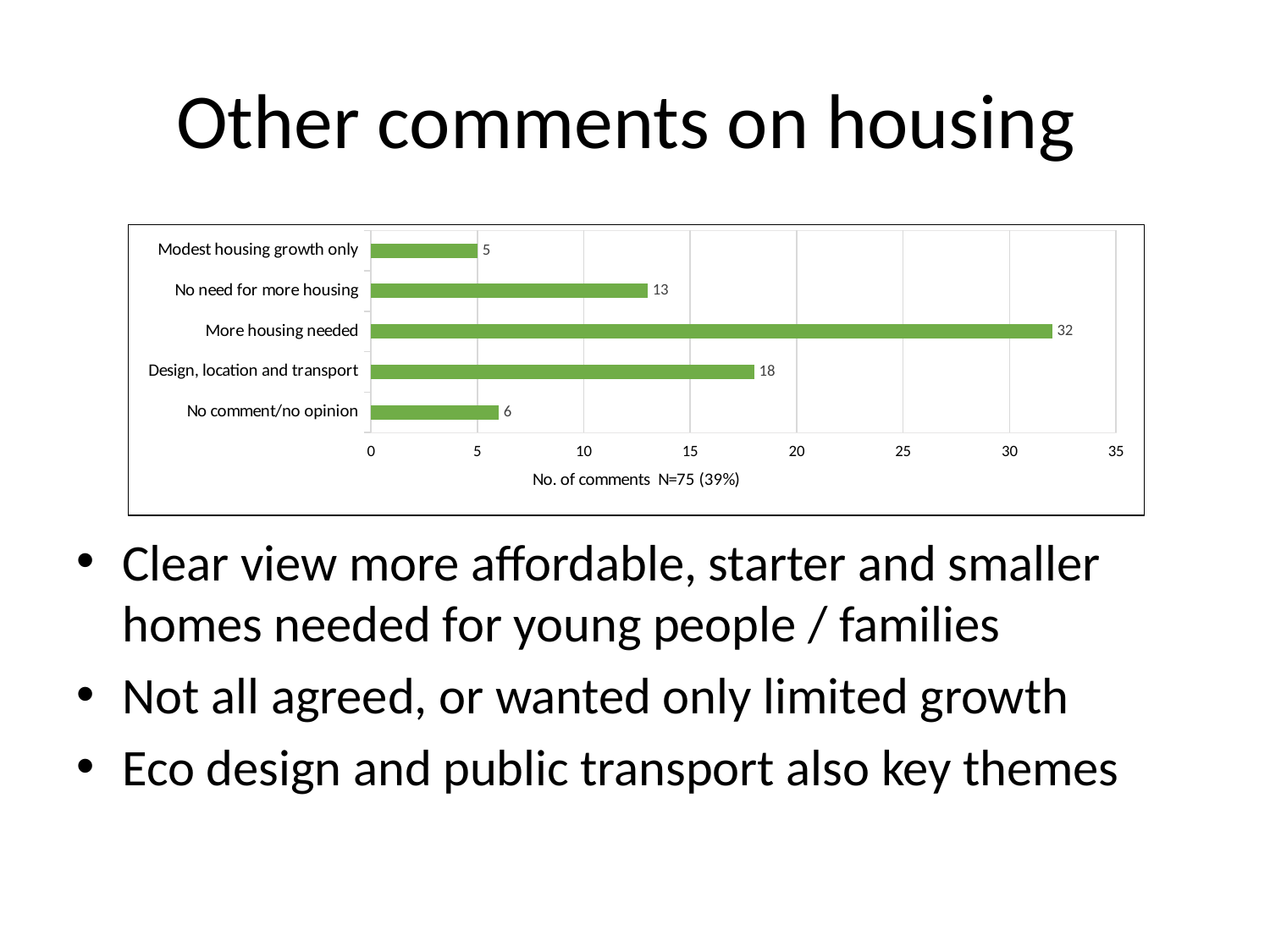
How many comments fall under 'No need for more housing'? 13 What is the value for 'No comment/no opinion'? 6 How many comments are in the 'More housing needed' category? 32 Which category has the lowest number of comments? Modest housing growth only Is the value for 'More housing needed' greater or less than 30? greater What is the label on the horizontal axis of the chart? No. of comments N=75 (39%) What is the value for 'Design, location and transport'? 18 What kind of chart is shown on the slide? Bar chart What is the difference between 'More housing needed' and 'No need for more housing'? 19 Which category has the highest number of comments? More housing needed Which is larger: 'Design, location and transport' or 'No need for more housing'? Design, location and transport How many categories are shown in the chart? 5